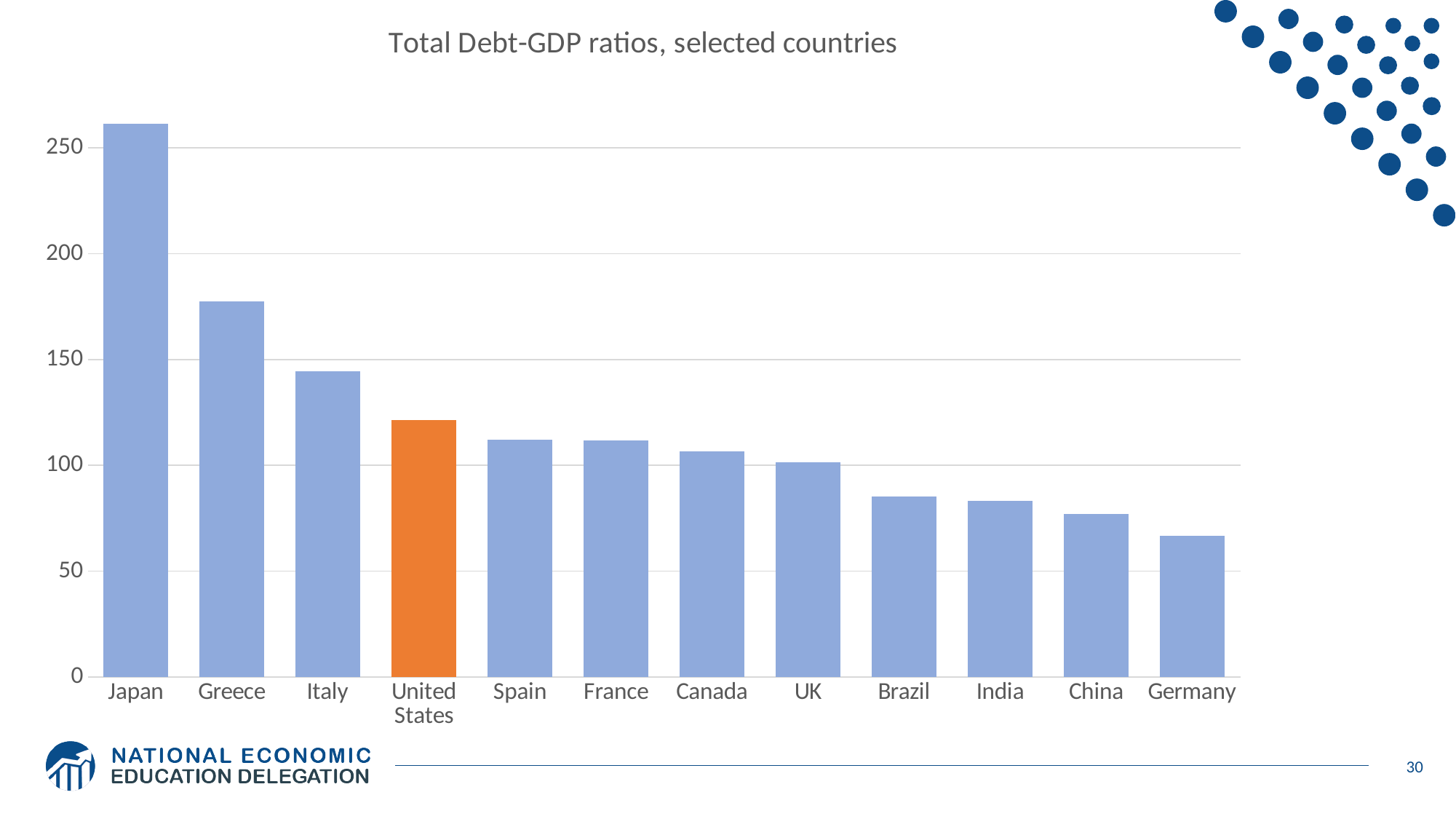
What kind of chart is shown on the slide? bar chart What is the title of the chart? Total Debt-GDP ratios, selected countries Which has a higher total debt-GDP ratio, Italy or Spain? Italy Is the value for Greece greater or less than 200? less Is the value for the United States greater or less than 100? greater Which country's bar is coloured orange? United States Is the value for Germany greater or less than 50? greater Which country has the highest total debt-GDP ratio? Japan Which country has the lowest total debt-GDP ratio? Germany How many countries are shown on the chart? 12 Do the values rise or fall moving from left to right along the x axis? fall